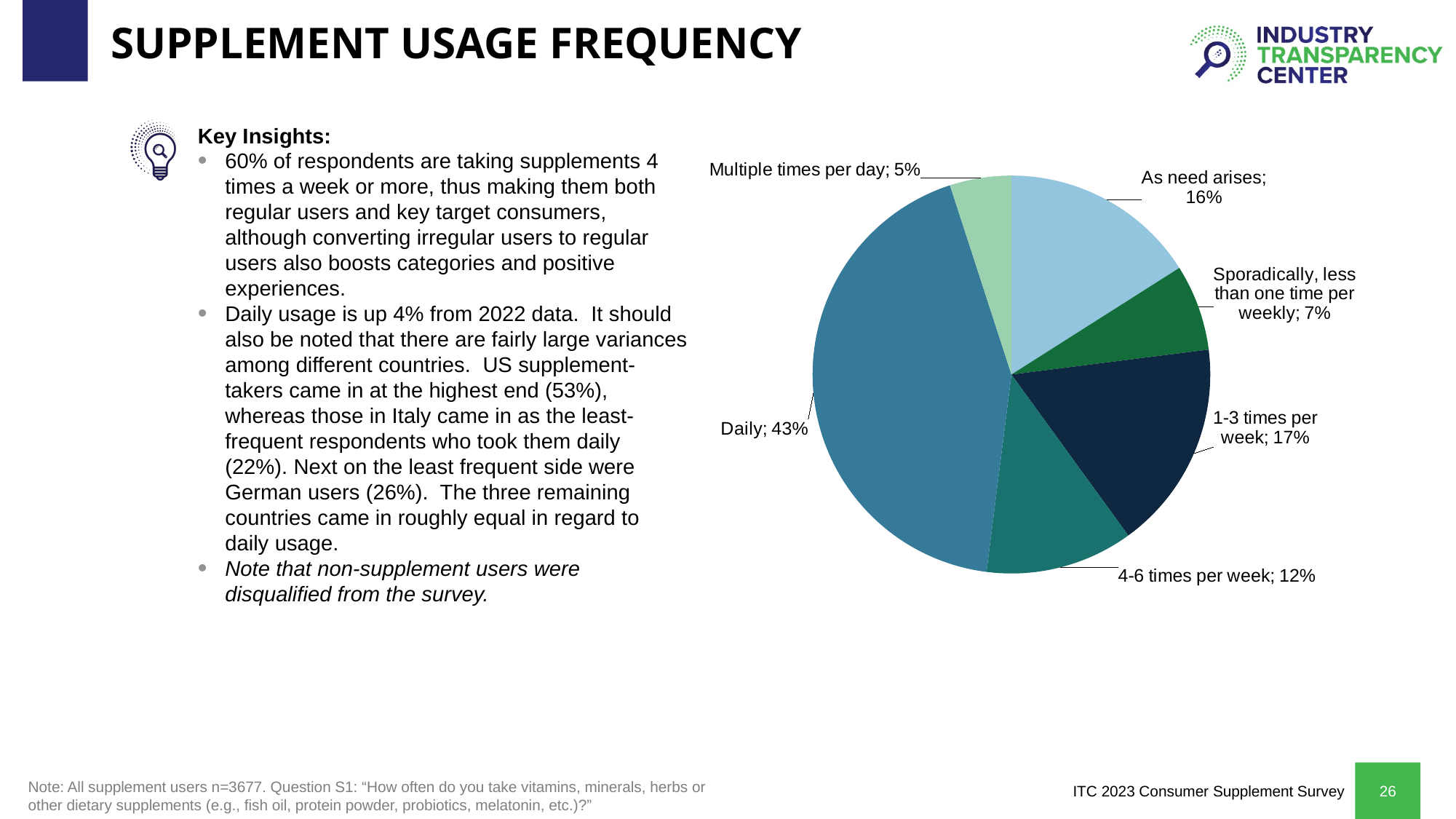
How many categories are shown in the pie chart? 6 Which is larger: the share for 'As need arises' or the share for '4-6 times per week'? As need arises What is the difference in percentage points between the Daily slice and the 1-3 times per week slice? 26 What percentage of respondents take supplements 4-6 times per week? 12% What share of respondents take supplements daily? 43% Which usage frequency category has the smallest share of the pie? Multiple times per day What is the combined share of the '1-3 times per week' and 'Sporadically, less than one time per weekly' slices? 24% What share of respondents take supplements as need arises? 16% What percentage of respondents take supplements multiple times per day? 5% Which usage frequency category has the largest share of the pie? Daily What type of chart is shown on the slide? Pie chart What is the title of the slide containing the chart? Supplement Usage Frequency